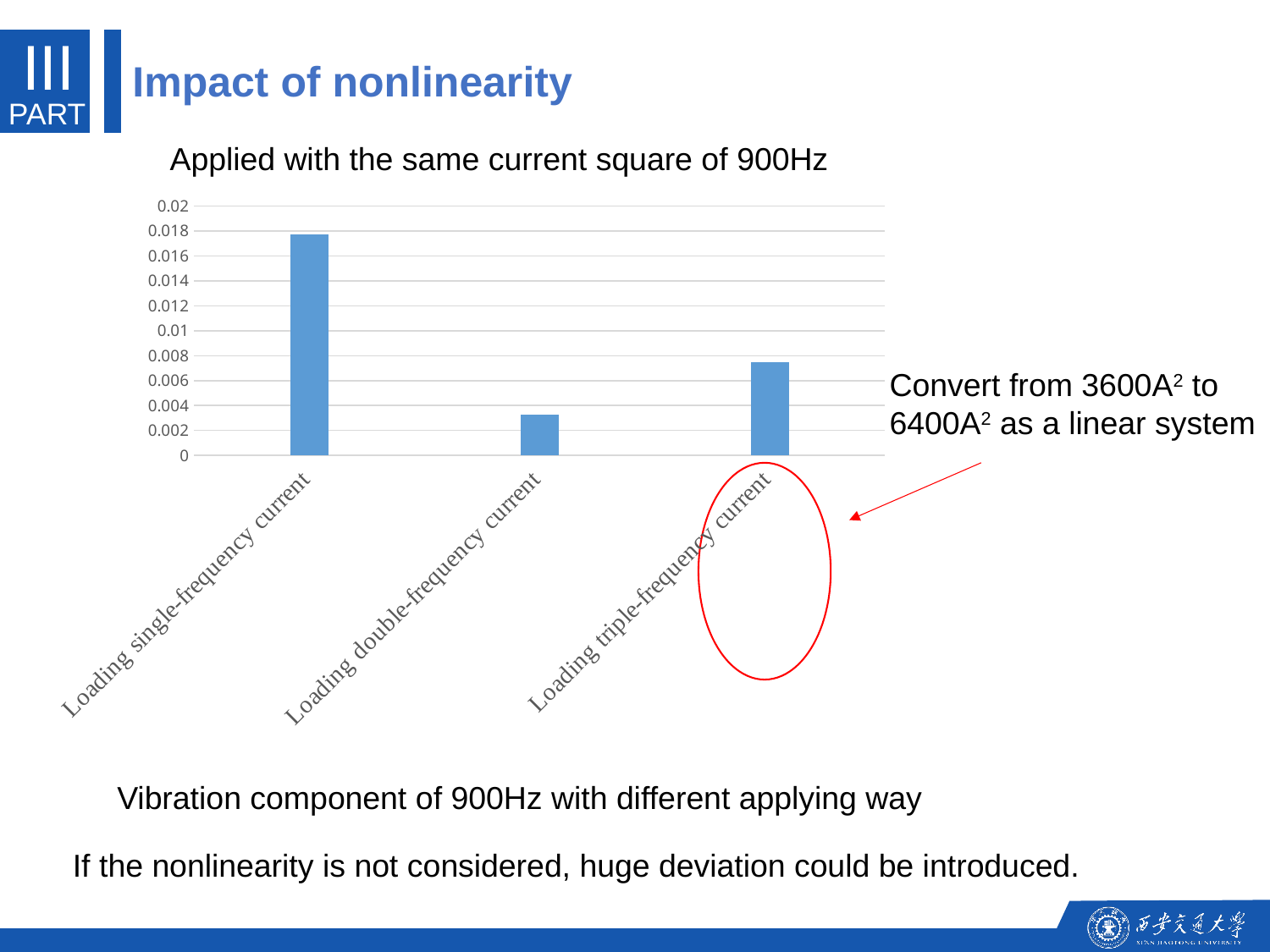
Which is larger, the value for Loading single-frequency current or the value for Loading triple-frequency current? Loading single-frequency current Is the value for Loading single-frequency current greater or less than 0.016? greater What kind of chart is shown on the slide? bar chart Which category has the highest bar in the chart? Loading single-frequency current How many categories are plotted in the bar chart? 3 Is the value for Loading double-frequency current greater or less than 0.004? less Which is larger, the value for Loading triple-frequency current or the value for Loading double-frequency current? Loading triple-frequency current What is the highest tick value shown on the vertical axis of the chart? 0.02 Is the value for Loading triple-frequency current greater or less than 0.006? greater Which category has the lowest bar in the chart? Loading double-frequency current What colour are the bars in the chart? blue